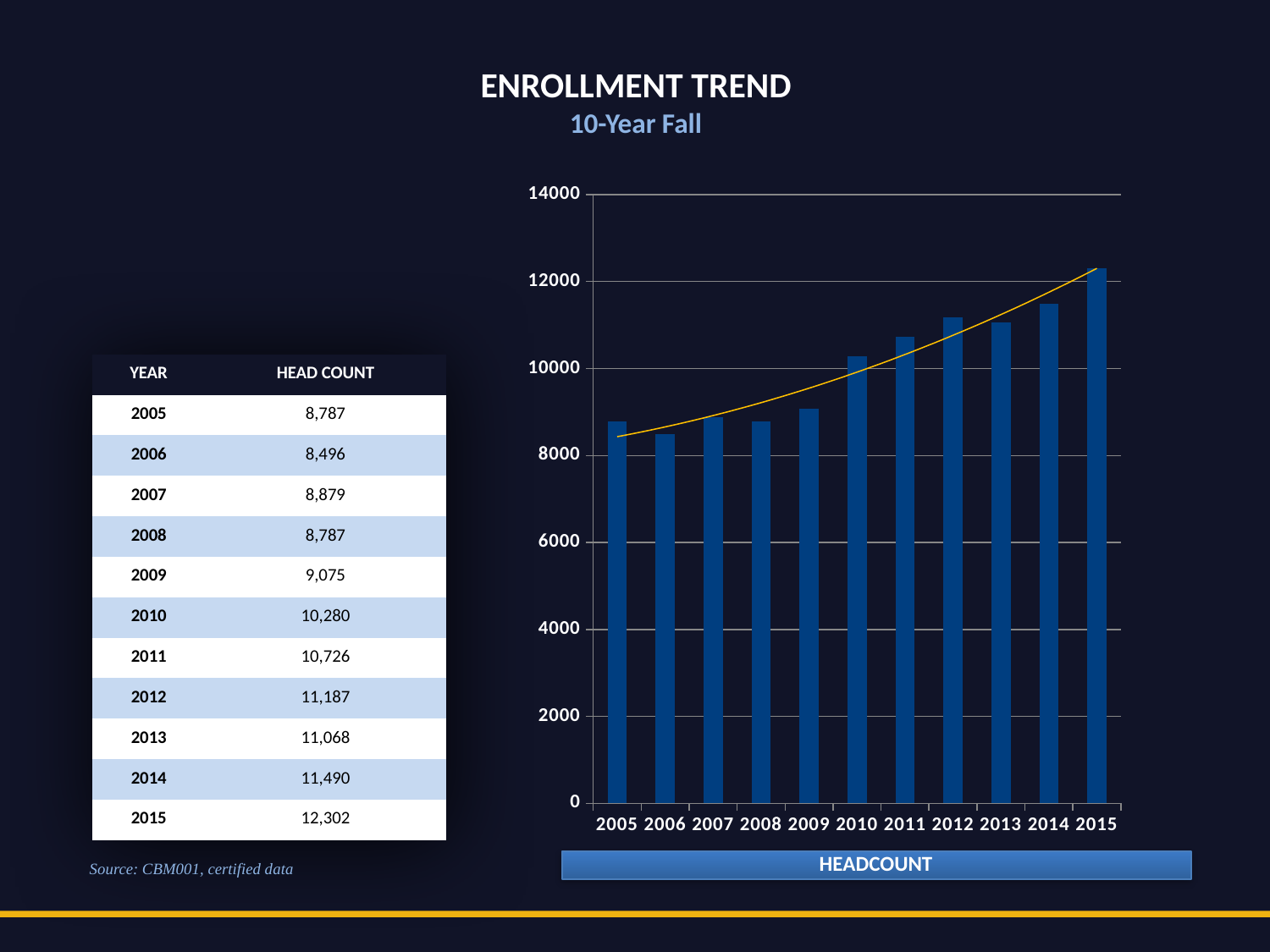
What type of chart is shown on the slide? bar chart What is the title of the chart on the slide? ENROLLMENT TREND Overall, does the headcount rise or fall from 2005 to 2015? rise What is the headcount for 2010 according to the slide? 10,280 Which year has a larger headcount, 2012 or 2013? 2012 What is the difference in headcount between 2015 and 2005? 3,515 Which year has the lowest headcount? 2006 What is the headcount for 2015 according to the slide? 12,302 Is the headcount for 2009 greater or less than 10000? less Is the headcount for 2014 greater or less than 10000? greater How many years are shown on the x axis of the chart? 11 Which year has the highest headcount? 2015